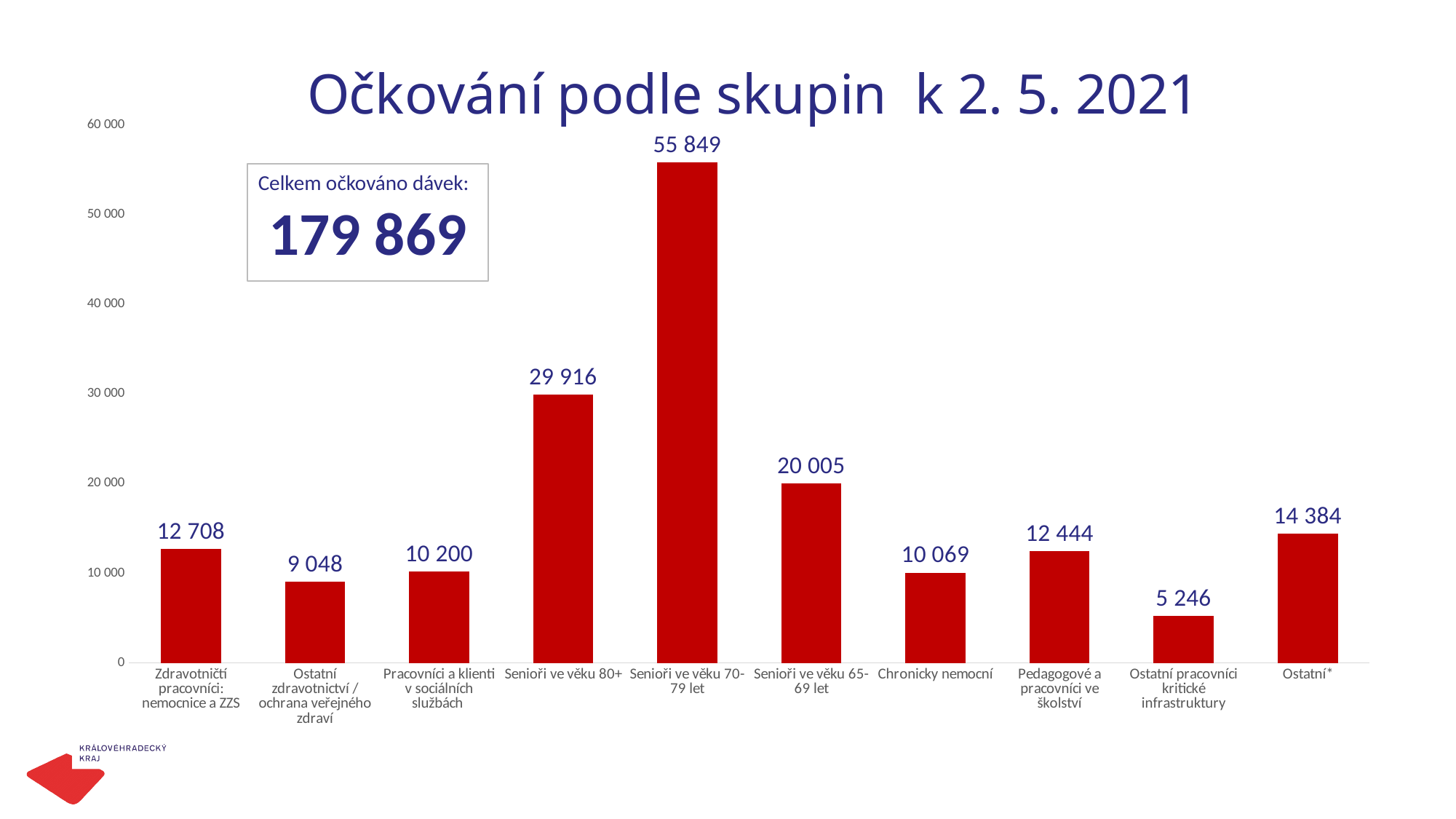
What is the value for Ostatní pracovníci kritické infrastruktury? 5 246 Which category has the highest value? Senioři ve věku 70-79 let What kind of chart is shown on the slide? bar chart What is the value for Senioři ve věku 80+? 29 916 What is the value for Pedagogové a pracovníci ve školství? 12 444 How many categories are shown on the x axis? 10 What total number of doses (Celkem očkováno dávek) is shown in the box on the slide? 179 869 What is the difference between the values for Senioři ve věku 70-79 let and Senioři ve věku 80+? 25 933 Is the value for Senioři ve věku 65-69 let greater or less than 20 000? greater Which is larger, the value for Zdravotničtí pracovníci: nemocnice a ZZS or the value for Ostatní*? Ostatní* What is the title of the chart? Očkování podle skupin k 2. 5. 2021 Which category has the lowest value? Ostatní pracovníci kritické infrastruktury